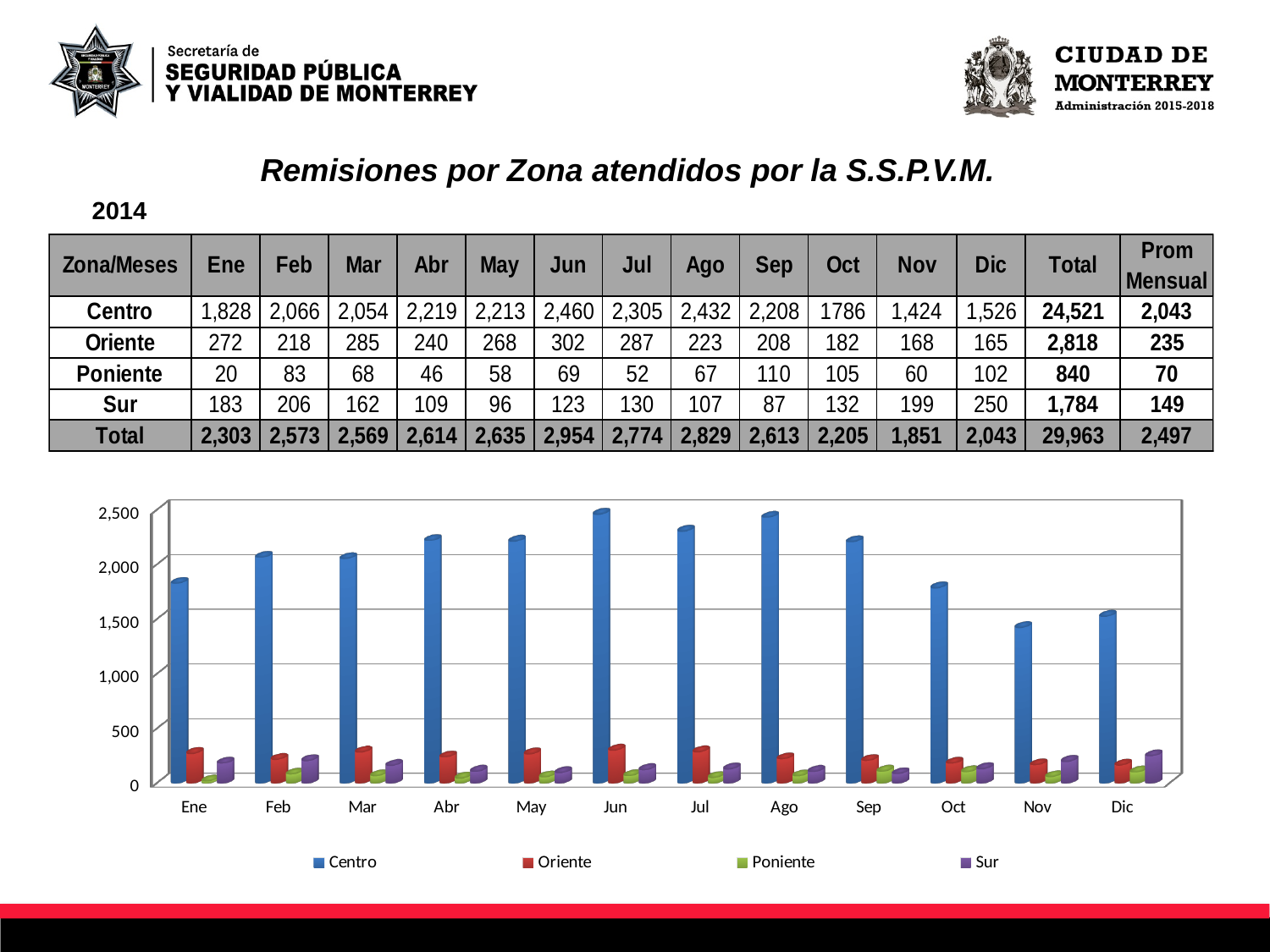
Do the Centro values rise or fall from Sep to Nov? fall In which month is the Centro value lowest? Nov What colour are the Centro bars in the chart? blue Is the Centro value for Jun greater or less than 2,000? greater What is the difference between the Centro values for Feb and Ene? 238 What is the Centro value for Ene? 1,828 How many months are shown along the x axis of the chart? 12 Is the Centro value for Nov greater or less than 1,500? less What is the Poniente value for Sep? 110 How many series does the chart legend list? 4 In Dic, which is larger, the Oriente value or the Sur value? Sur What kind of chart is shown on the slide? bar chart